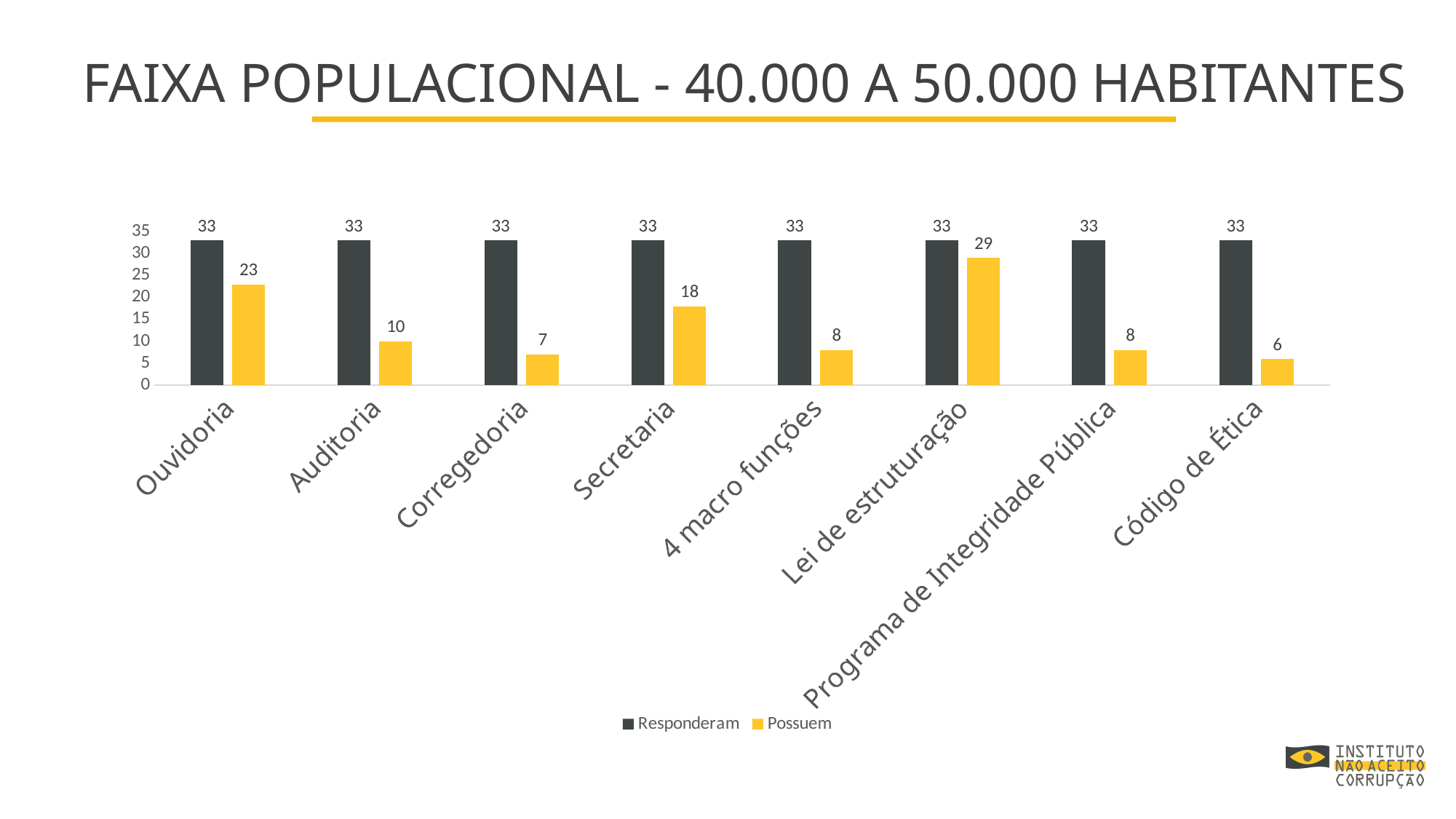
Which category has the lowest 'Possuem' value? Código de Ética What is the 'Responderam' value for Secretaria? 33 How many categories are shown on the x axis? 8 What is the 'Possuem' value for 4 macro funções? 8 How many series does the legend list? 2 What colour are the 'Possuem' bars? Yellow Which is larger, the 'Possuem' value for Secretaria or for Corregedoria? Secretaria Which category has the highest 'Possuem' value? Lei de estruturação What is the difference between the 'Responderam' and 'Possuem' values for Auditoria? 23 What kind of chart is shown on the slide? Bar chart What is the 'Possuem' value for Lei de estruturação? 29 What is the 'Possuem' value for Ouvidoria? 23